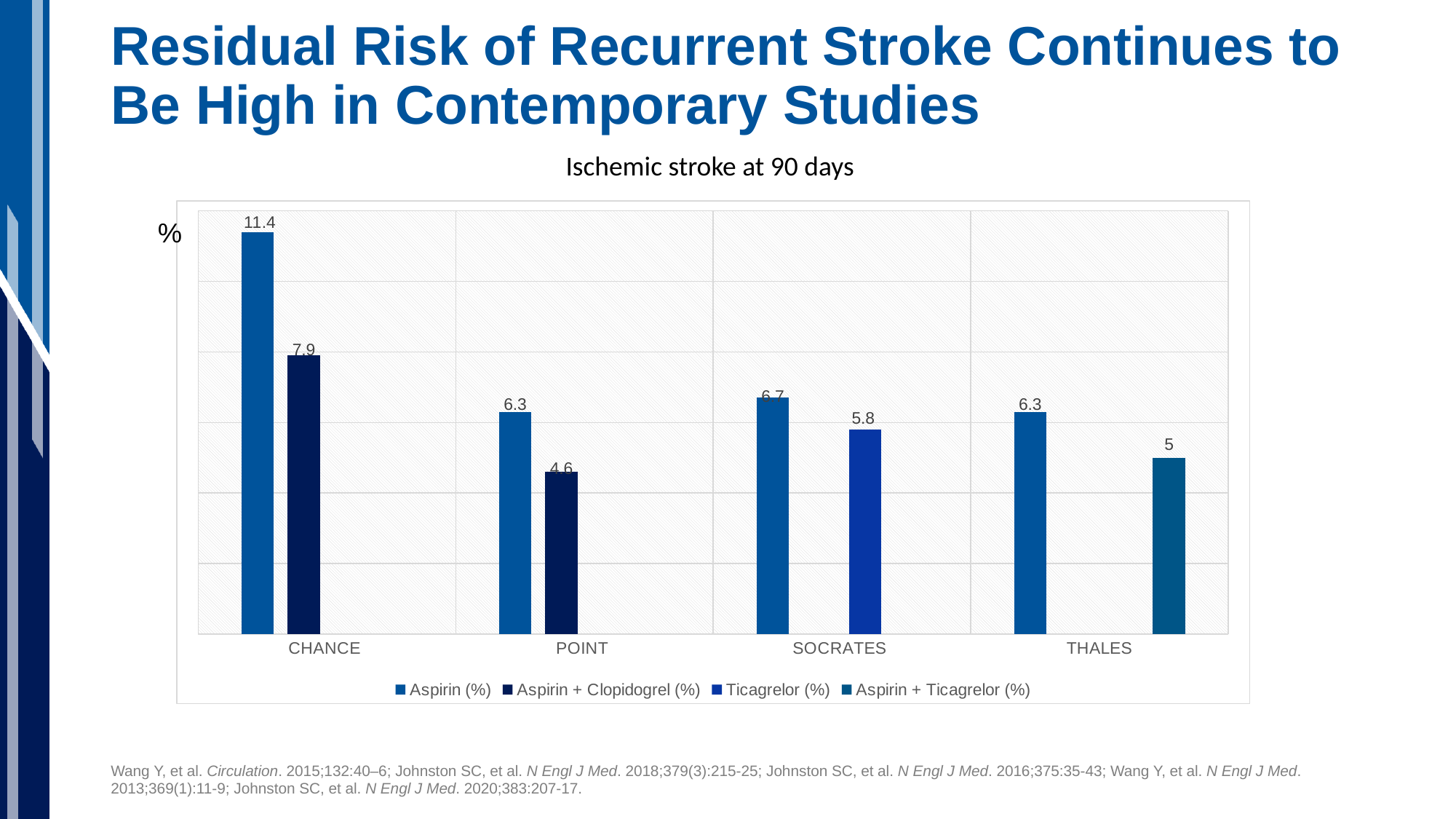
Which trial has the highest Aspirin (%) value? CHANCE What is the Aspirin (%) value for CHANCE? 11.4 What is the title of the chart? Ischemic stroke at 90 days How many trials are shown on the x axis? 4 How many series does the legend list? 4 Which bar shows the lowest value on the chart? Aspirin + Clopidogrel (%) for POINT What is the Ticagrelor (%) value for SOCRATES? 5.8 Which is larger: the Aspirin (%) value for SOCRATES or the Aspirin (%) value for THALES? SOCRATES What is the Aspirin + Ticagrelor (%) value for THALES? 5 What is the difference between the Aspirin (%) and Aspirin + Clopidogrel (%) values for CHANCE? 3.5 What kind of chart is shown on the slide? Bar chart What is the Aspirin + Clopidogrel (%) value for POINT? 4.6